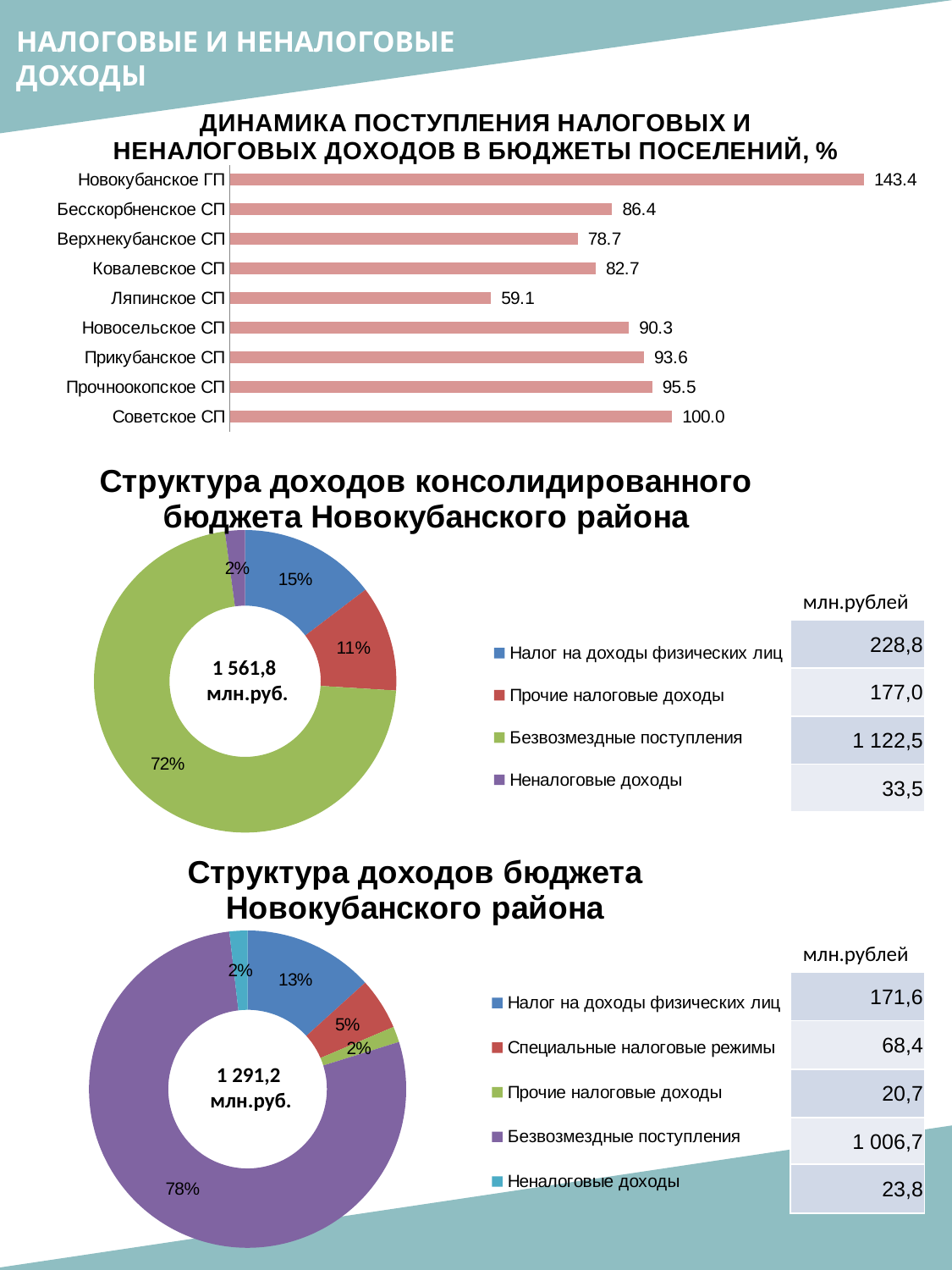
On the chart 'Структура доходов консолидированного бюджета Новокубанского района', what share do Безвозмездные поступления have? 72% On the chart 'Структура доходов бюджета Новокубанского района', what is the value in млн.рублей for Специальные налоговые режимы? 68,4 On the bar chart 'Динамика поступления налоговых и неналоговых доходов в бюджеты поселений, %', which is larger: Бесскорбненское СП or Ковалевское СП? Бесскорбненское СП On the bar chart 'Динамика поступления налоговых и неналоговых доходов в бюджеты поселений, %', which settlement has the lowest value? Ляпинское СП On the chart 'Структура доходов консолидированного бюджета Новокубанского района', what is the value in млн.рублей for Налог на доходы физических лиц? 228,8 On the chart 'Структура доходов бюджета Новокубанского района', what total in млн.руб. is shown in the centre of the doughnut? 1 291,2 On the bar chart 'Динамика поступления налоговых и неналоговых доходов в бюджеты поселений, %', which settlement has the highest value? Новокубанское ГП What kind of chart is 'Динамика поступления налоговых и неналоговых доходов в бюджеты поселений, %'? Bar chart On the bar chart 'Динамика поступления налоговых и неналоговых доходов в бюджеты поселений, %', what is the value for Ляпинское СП? 59.1 On the bar chart 'Динамика поступления налоговых и неналоговых доходов в бюджеты поселений, %', what is the difference between Новокубанское ГП and Советское СП? 43.4 How many categories does the legend list on the chart 'Структура доходов консолидированного бюджета Новокубанского района'? 4 How many settlements are shown on the bar chart 'Динамика поступления налоговых и неналоговых доходов в бюджеты поселений, %'? 9